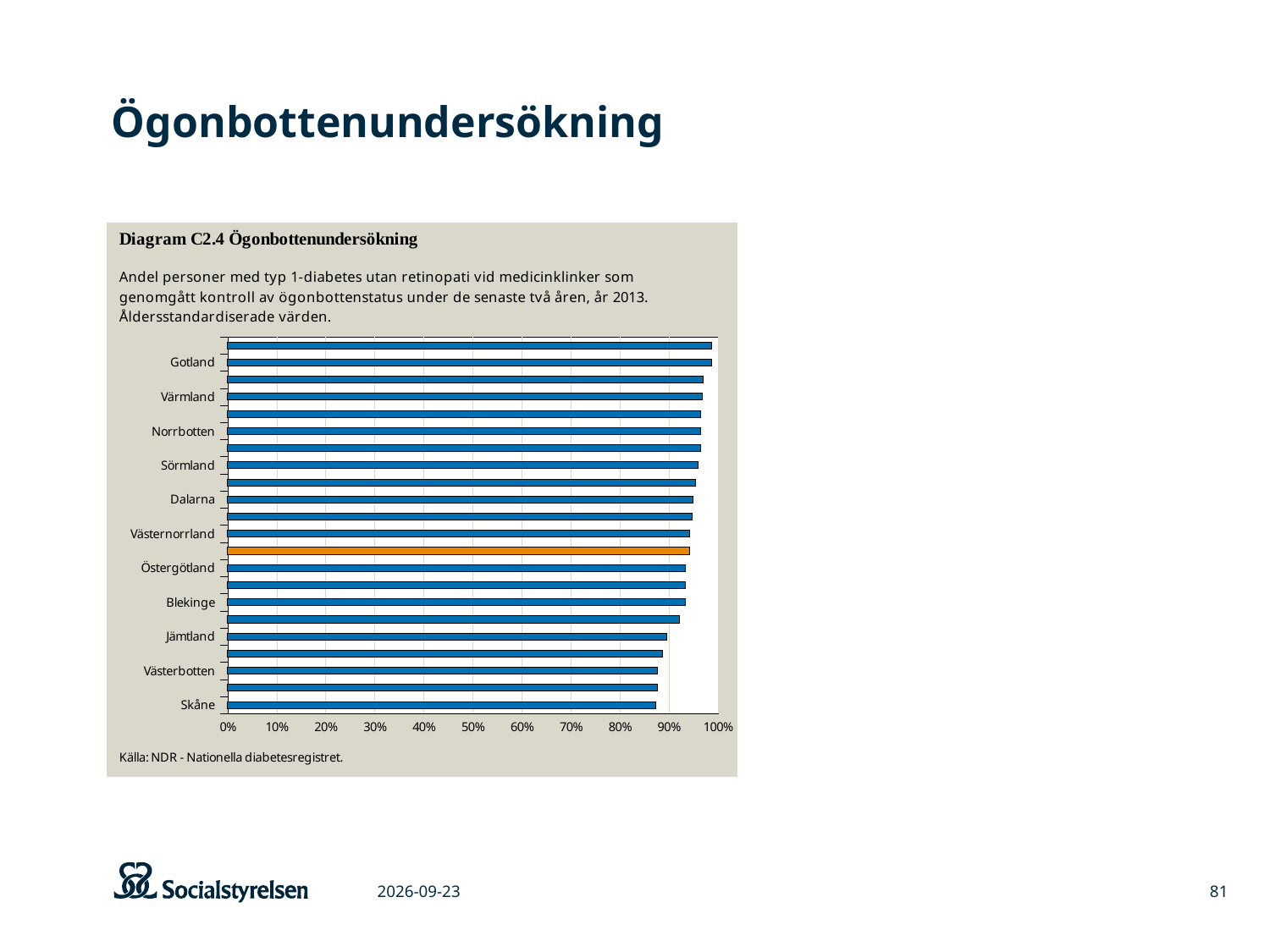
Do the bar values increase or decrease going from the top of the chart to the bottom? decrease Is the value for Värmland greater or less than 80%? greater What kind of chart is shown in Diagram C2.4? bar chart Is the value for Skåne greater or less than 90%? less Is the value for Blekinge greater or less than 90%? greater Which has the larger value, Gotland or Skåne? Gotland How many bars are plotted in the chart? 22 Which has the larger value, Dalarna or Västerbotten? Dalarna What is the highest value shown on the horizontal axis? 100% What colour is the single bar that differs from the others? orange